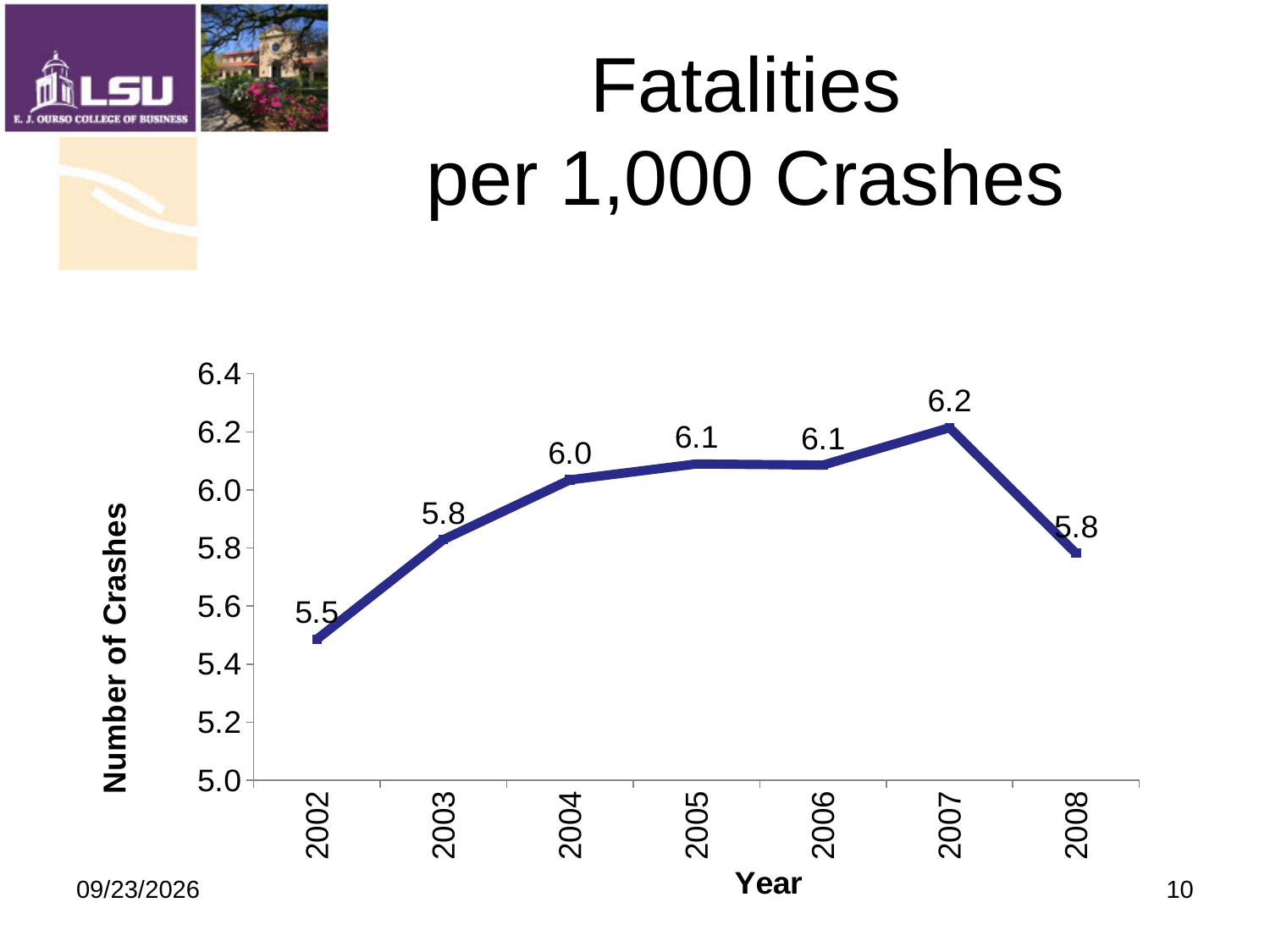
What is the difference between the values for 2007 and 2002? 0.7 Does the value rise or fall from 2007 to 2008? fall What is the value for 2004? 6.0 Which year has the highest value? 2007 What is the value for 2007? 6.2 Which year has the lowest value? 2002 How many years are plotted on the x axis? 7 What is the value for 2002? 5.5 What is the value for 2008? 5.8 Which is larger, the value for 2004 or the value for 2008? 2004 What type of chart is shown on the slide? line chart What is the label of the x axis? Year